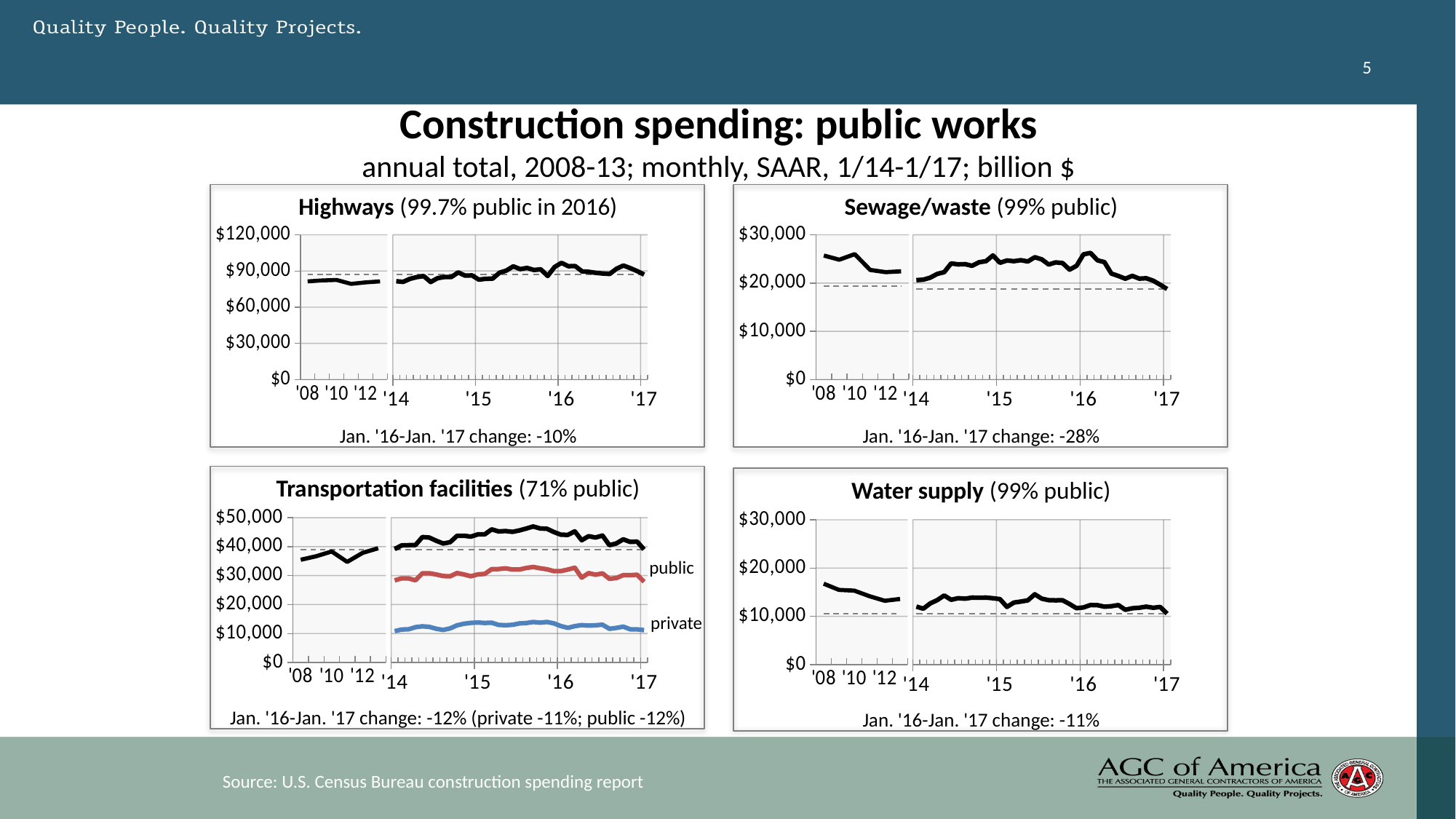
In the Sewage/waste chart, what is the Jan. '16-Jan. '17 change? -28% In the Transportation facilities chart, which series is larger in 2016, public or private? public In the Highways chart, what is the Jan. '16-Jan. '17 change? -10% How many charts are shown on the slide? 4 Which of the four charts shows the largest Jan. '16-Jan. '17 decline? Sewage/waste In the Sewage/waste chart, do values rise or fall from '16 to '17? fall In the Transportation facilities chart, what is the Jan. '16-Jan. '17 change for private spending? -11% In the Transportation facilities chart, is the private value for '17 greater or less than $20,000? less What kind of chart is the Highways chart? line chart In the Water supply chart, what is the Jan. '16-Jan. '17 change? -11% According to the Transportation facilities chart title, what share of transportation facilities spending is public? 71% In the Highways chart, is the value for '08 greater or less than $60,000? greater